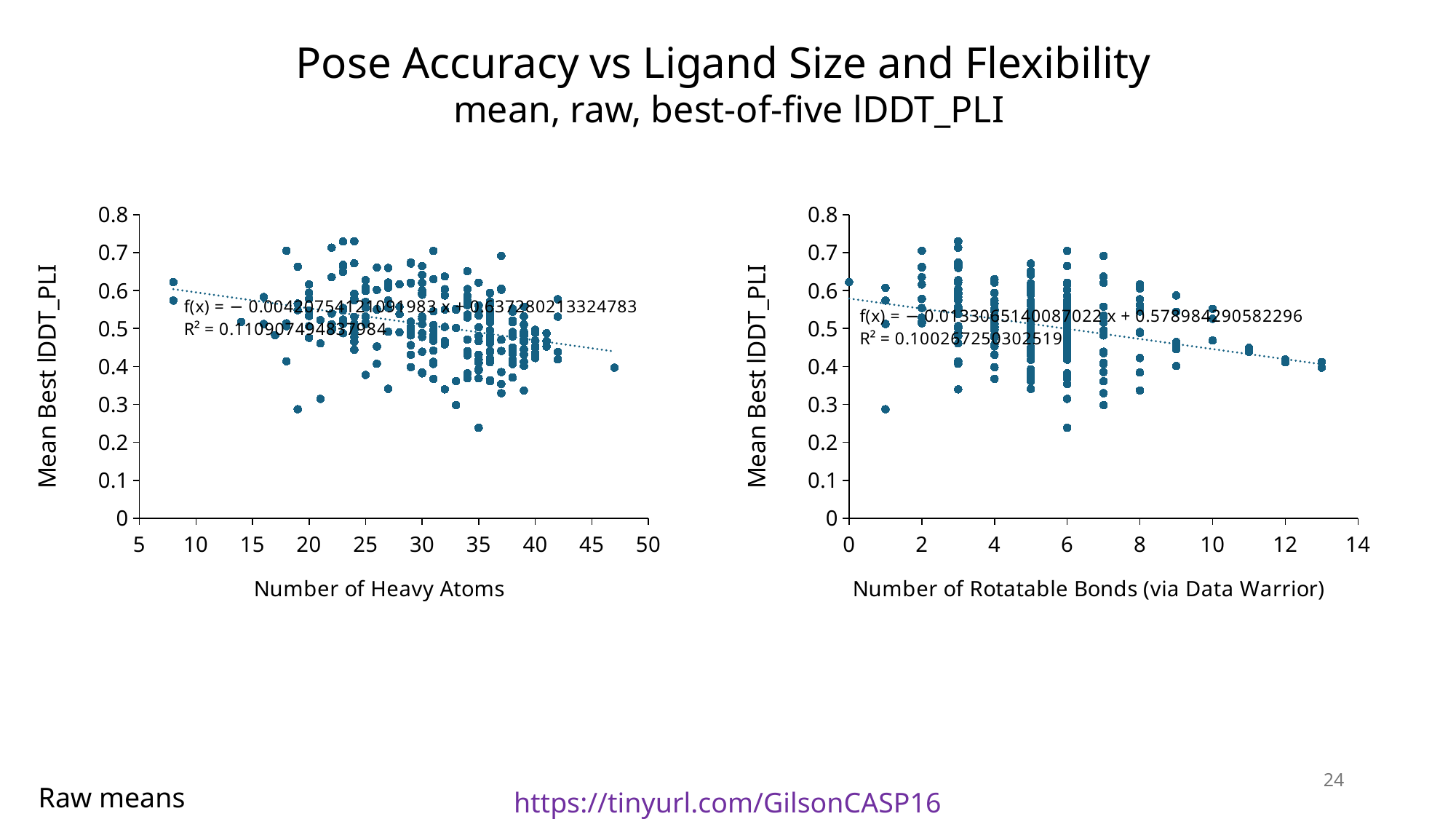
What is the y-axis label shared by both charts? Mean Best lDDT_PLI In the left chart, is the Mean Best lDDT_PLI for the point at 47 heavy atoms greater or less than 0.5? less What is the slope of the fitted line shown on the right chart (Number of Rotatable Bonds)? −0.0133065140087022 In the right chart, is the lowest point at 6 rotatable bonds greater or less than 0.3? less What is the x-axis label of the left chart? Number of Heavy Atoms What kind of chart is the left chart, 'Number of Heavy Atoms'? Scatter plot In the right chart, does the fitted trend line rise or fall as the number of rotatable bonds increases? Falls What is the R² value shown on the right chart (Number of Rotatable Bonds)? 0.100267250302519 What kind of chart is the right chart, 'Number of Rotatable Bonds (via Data Warrior)'? Scatter plot In the left chart, does the fitted trend line rise or fall as the number of heavy atoms increases? Falls What is the intercept of the fitted line shown on the right chart (Number of Rotatable Bonds)? 0.578984290582296 In the right chart, is the Mean Best lDDT_PLI for the points at 13 rotatable bonds greater or less than 0.5? less